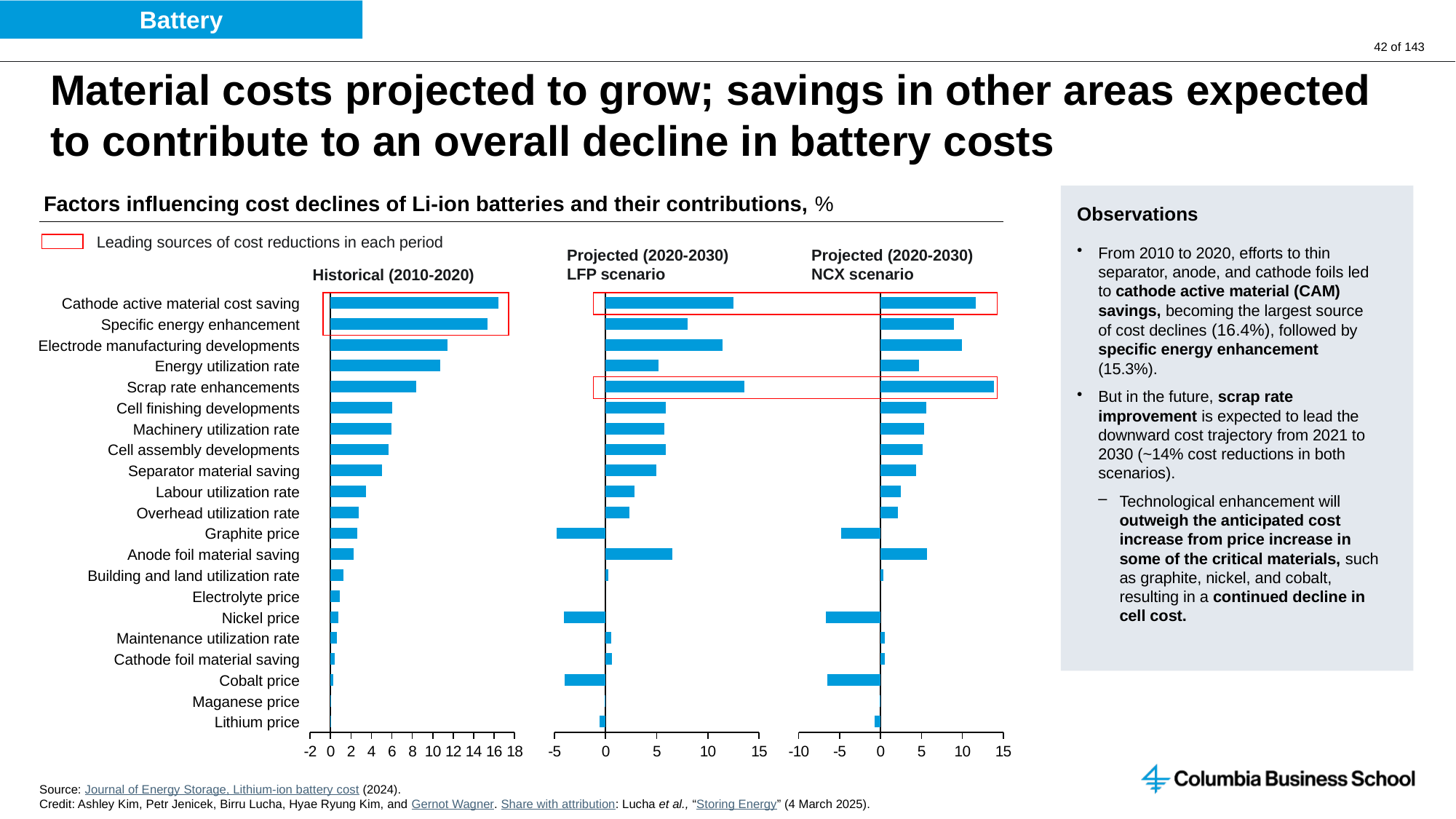
In the Historical (2010-2020) chart, is the value for Cathode active material cost saving greater or less than 14? greater In the Projected (2020-2030) NCX scenario chart, is the value for Cobalt price greater or less than -5? less According to the legend, what do the red boxes around bars indicate? Leading sources of cost reductions in each period In the Projected (2020-2030) LFP scenario chart, which factor has the highest value? Scrap rate enhancements In the Historical (2010-2020) chart, which is larger: Cell finishing developments or Labour utilization rate? Cell finishing developments In the Projected (2020-2030) NCX scenario chart, which factor has the highest value? Scrap rate enhancements In the Historical (2010-2020) chart, which factor has the highest value? Cathode active material cost saving In the Projected (2020-2030) LFP scenario chart, is the value for Graphite price greater or less than 0? less What kind of chart is used for the Historical (2010-2020) panel? Bar chart How many categories (factors) are listed on the y axis of the charts? 21 In the Projected (2020-2030) LFP scenario chart, which is larger: Electrode manufacturing developments or Energy utilization rate? Electrode manufacturing developments